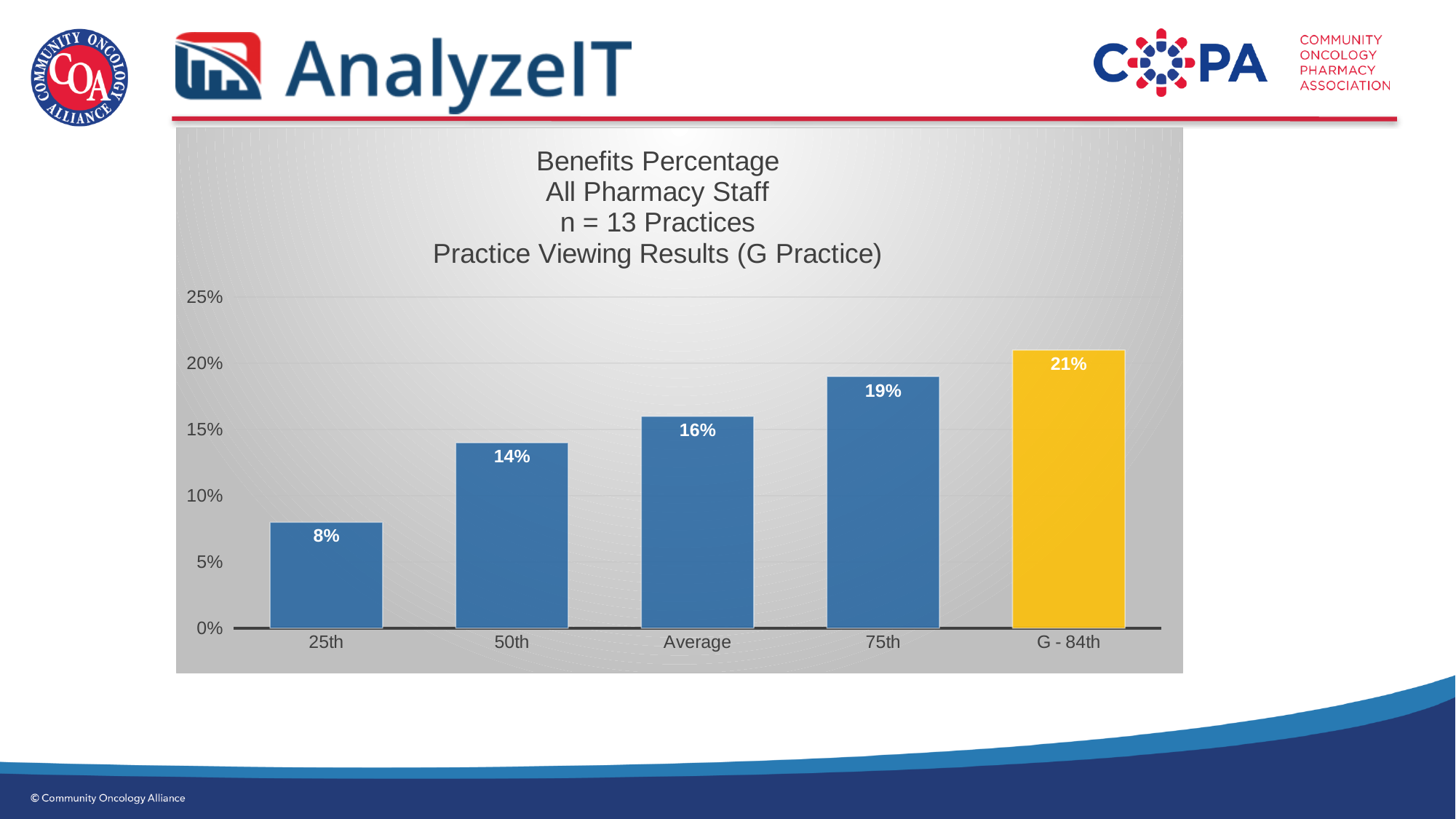
What is the Average benefits percentage? 16% Which is larger, the 50th percentile value or the Average value? Average Which category has the highest benefits percentage? G - 84th How many bars are shown in the chart? 5 What is the difference between the Average value and the 25th percentile value? 8% Which category has the lowest benefits percentage? 25th What is the benefits percentage for the 50th percentile? 14% What is the difference between the G - 84th value and the 75th percentile value? 2% What is the benefits percentage for G - 84th? 21% What type of chart is shown on the slide? Bar chart Which bar is coloured differently (yellow) from the others? G - 84th What is the benefits percentage for the 25th percentile? 8%